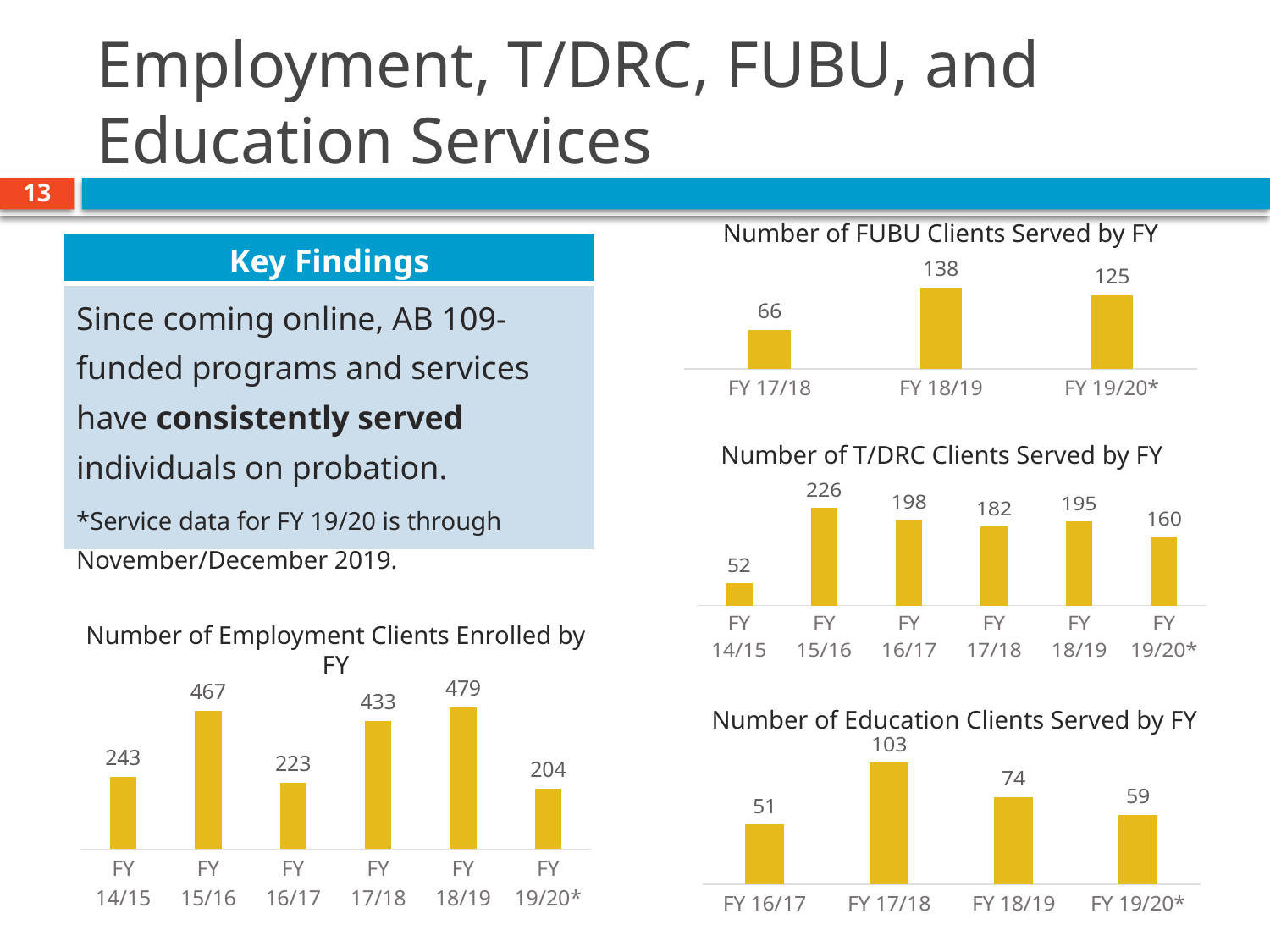
In the 'Number of Employment Clients Enrolled by FY' chart, what is the difference between FY 15/16 and FY 16/17? 244 What type of chart is the 'Number of FUBU Clients Served by FY' chart? Bar chart In the 'Number of FUBU Clients Served by FY' chart, what is the value for FY 18/19? 138 In the 'Number of FUBU Clients Served by FY' chart, which fiscal year has the lowest value? FY 17/18 In the 'Number of Employment Clients Enrolled by FY' chart, what is the value for FY 18/19? 479 In the 'Number of T/DRC Clients Served by FY' chart, how many fiscal years are shown? 6 In the 'Number of Education Clients Served by FY' chart, which is larger, FY 18/19 or FY 19/20*? FY 18/19 In the 'Number of Employment Clients Enrolled by FY' chart, which fiscal year has the lowest value? FY 19/20* In the 'Number of T/DRC Clients Served by FY' chart, what is the value for FY 14/15? 52 In the 'Number of T/DRC Clients Served by FY' chart, what is the difference between FY 15/16 and FY 19/20*? 66 In the 'Number of T/DRC Clients Served by FY' chart, which fiscal year has the highest value? FY 15/16 In the 'Number of Education Clients Served by FY' chart, what is the value for FY 17/18? 103